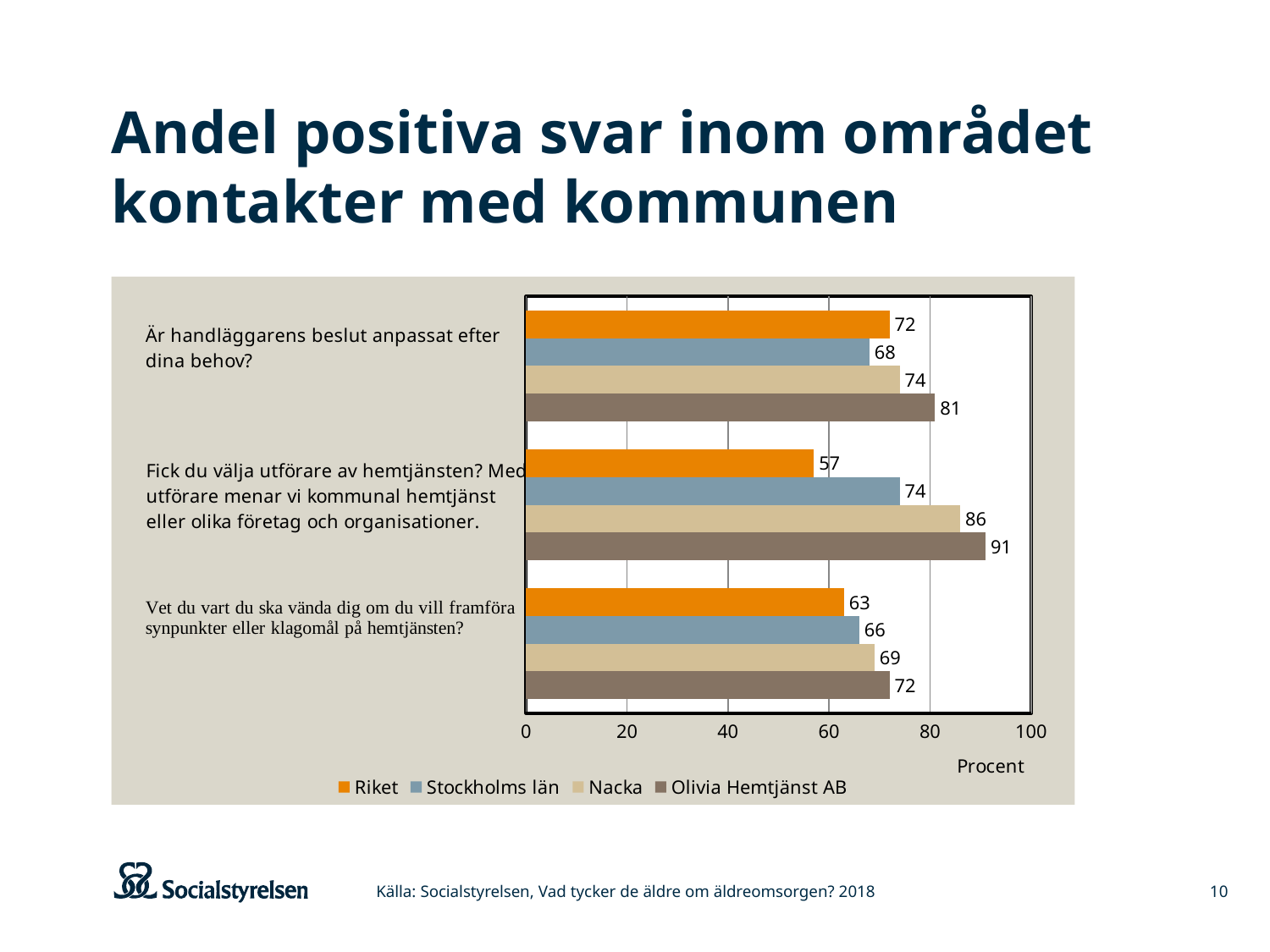
How many series does the legend list? 4 Is the value for Riket on "Fick du välja utförare av hemtjänsten?" greater or less than 60? less How many questions (categories) are shown on the chart? 3 What kind of chart is shown on the slide? bar chart Which series has the lowest value on the question "Är handläggarens beslut anpassat efter dina behov?" Stockholms län Which is larger on the question "Vet du vart du ska vända dig...": Nacka or Riket? Nacka What is the value for Riket on the question "Är handläggarens beslut anpassat efter dina behov?" 72 Which series has the highest value on the question "Fick du välja utförare av hemtjänsten?" Olivia Hemtjänst AB What unit is shown on the x axis of the chart? Procent What is the difference between Nacka and Riket on the question "Fick du välja utförare av hemtjänsten?" 29 What is the value for Olivia Hemtjänst AB on the question "Fick du välja utförare av hemtjänsten?" 91 What is the value for Stockholms län on the question "Vet du vart du ska vända dig om du vill framföra synpunkter eller klagomål på hemtjänsten?" 66